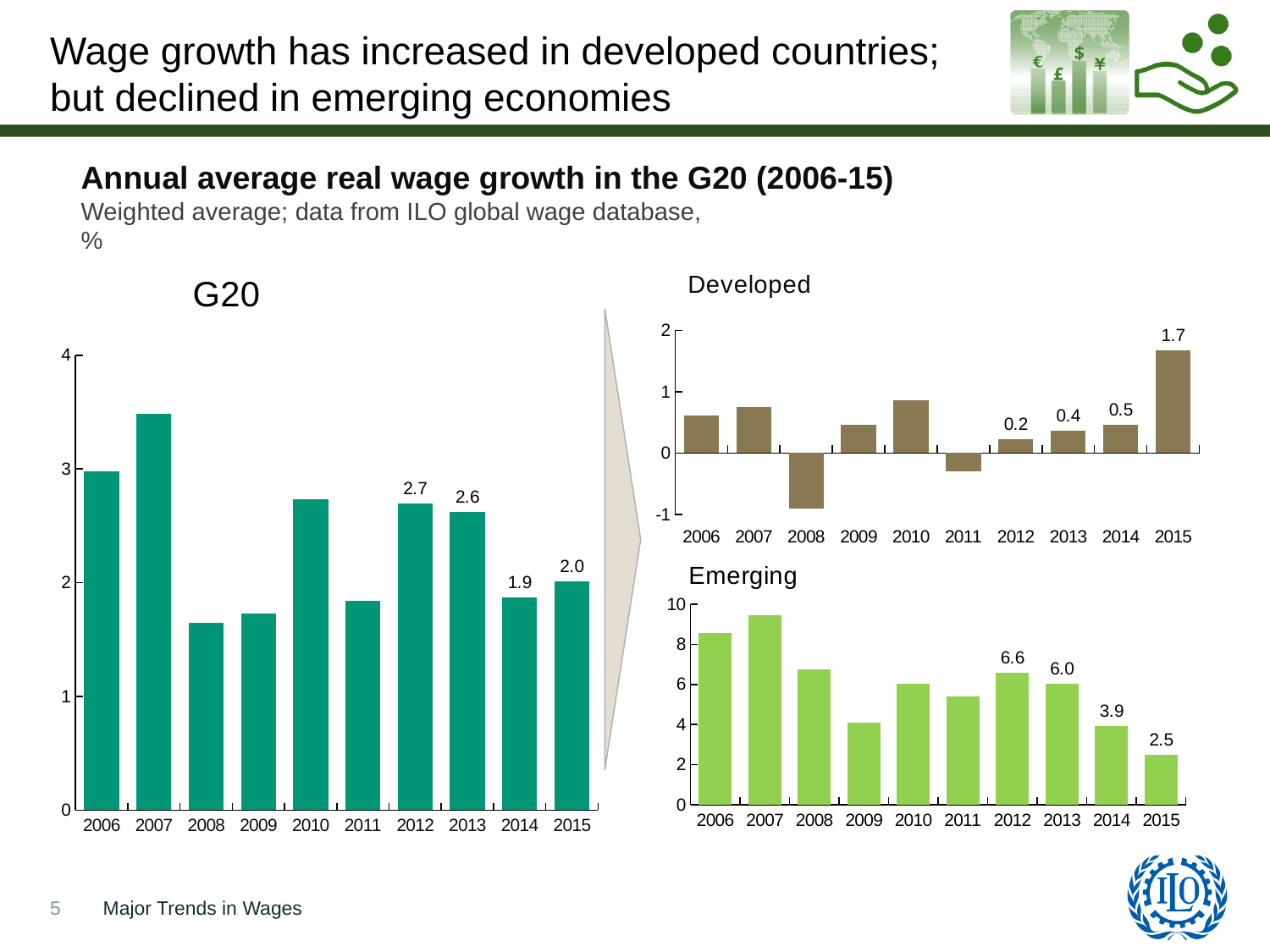
In the Developed chart, which is larger, the value for 2013 or the value for 2014? 2014 In the Emerging chart, what is the difference between the values for 2012 and 2015? 4.1 In the Emerging chart, which year has the lowest value? 2015 In the G20 chart, is the value for 2006 greater or less than 2? greater In the G20 chart, which year has the highest value? 2007 In the G20 chart, what is the value for 2012? 2.7 In the Developed chart, what is the value for 2015? 1.7 In the Emerging chart, what is the value for 2014? 3.9 How many years are shown on the x axis of the Developed chart? 10 In the Emerging chart, is the value for 2009 greater or less than 6? less What kind of chart is the Emerging chart? bar chart In the Developed chart, which year has the lowest value? 2008